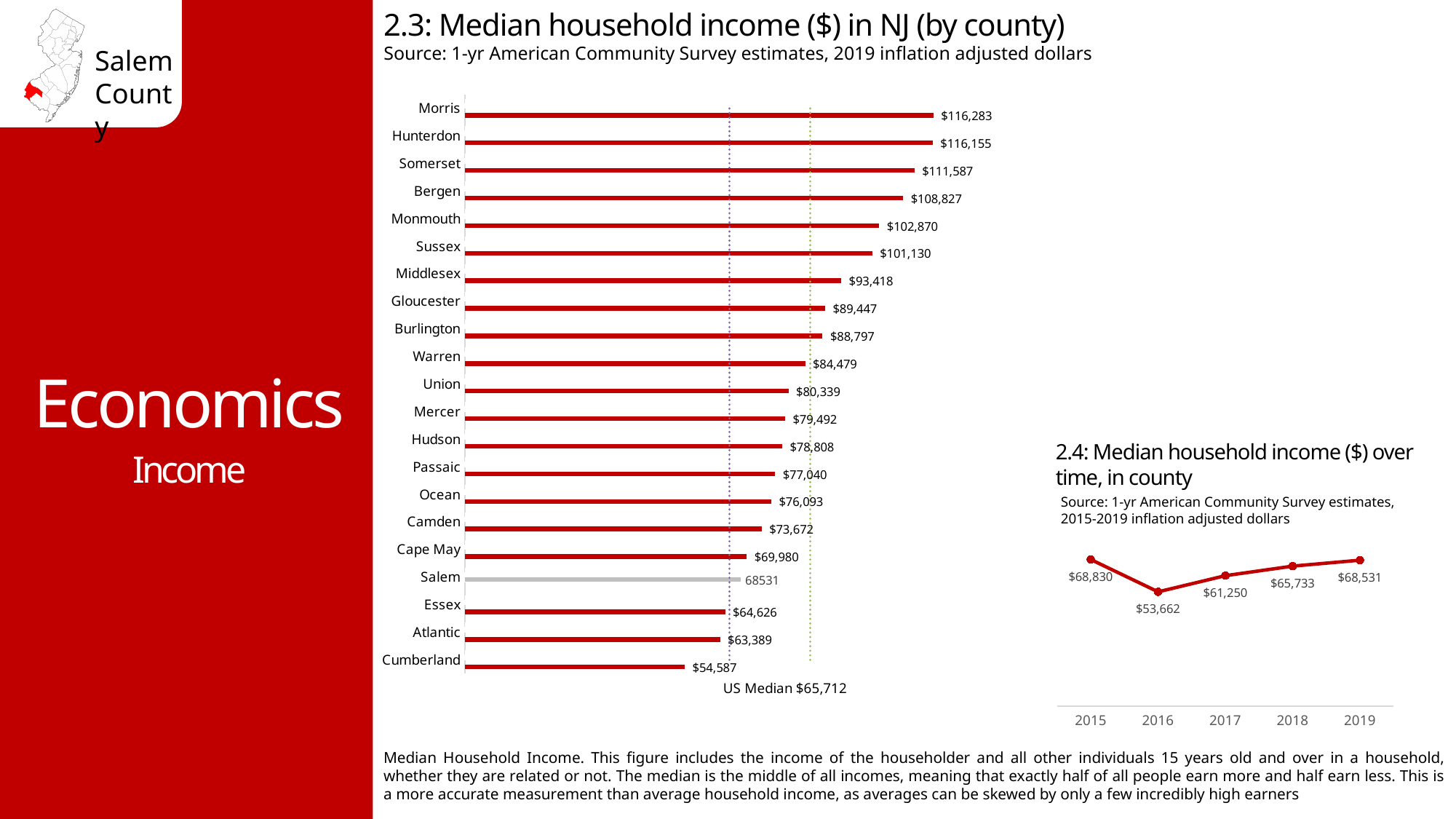
In chart 2.3 (Median household income by county), which county has the highest median household income? Morris In chart 2.3 (Median household income by county), what is the median household income for Morris? $116,283 In chart 2.3 (Median household income by county), what is the median household income for Cumberland? $54,587 In chart 2.4 (Median household income over time, in county), what is the difference between the 2019 and 2016 values? $14,869 In chart 2.4 (Median household income over time, in county), which year has the lowest value? 2016 What kind of chart is chart 2.4 (Median household income over time, in county)? Line chart In chart 2.3 (Median household income by county), how many counties are plotted? 21 In chart 2.3 (Median household income by county), which has a higher median household income, Gloucester or Burlington? Gloucester In chart 2.3 (Median household income by county), what is the difference between the values for Atlantic and Cumberland? $8,802 In chart 2.4 (Median household income over time, in county), what is the value for 2016? $53,662 In chart 2.3 (Median household income by county), what US median value is labelled on the chart? $65,712 In chart 2.3 (Median household income by county), which county has the lowest median household income? Cumberland